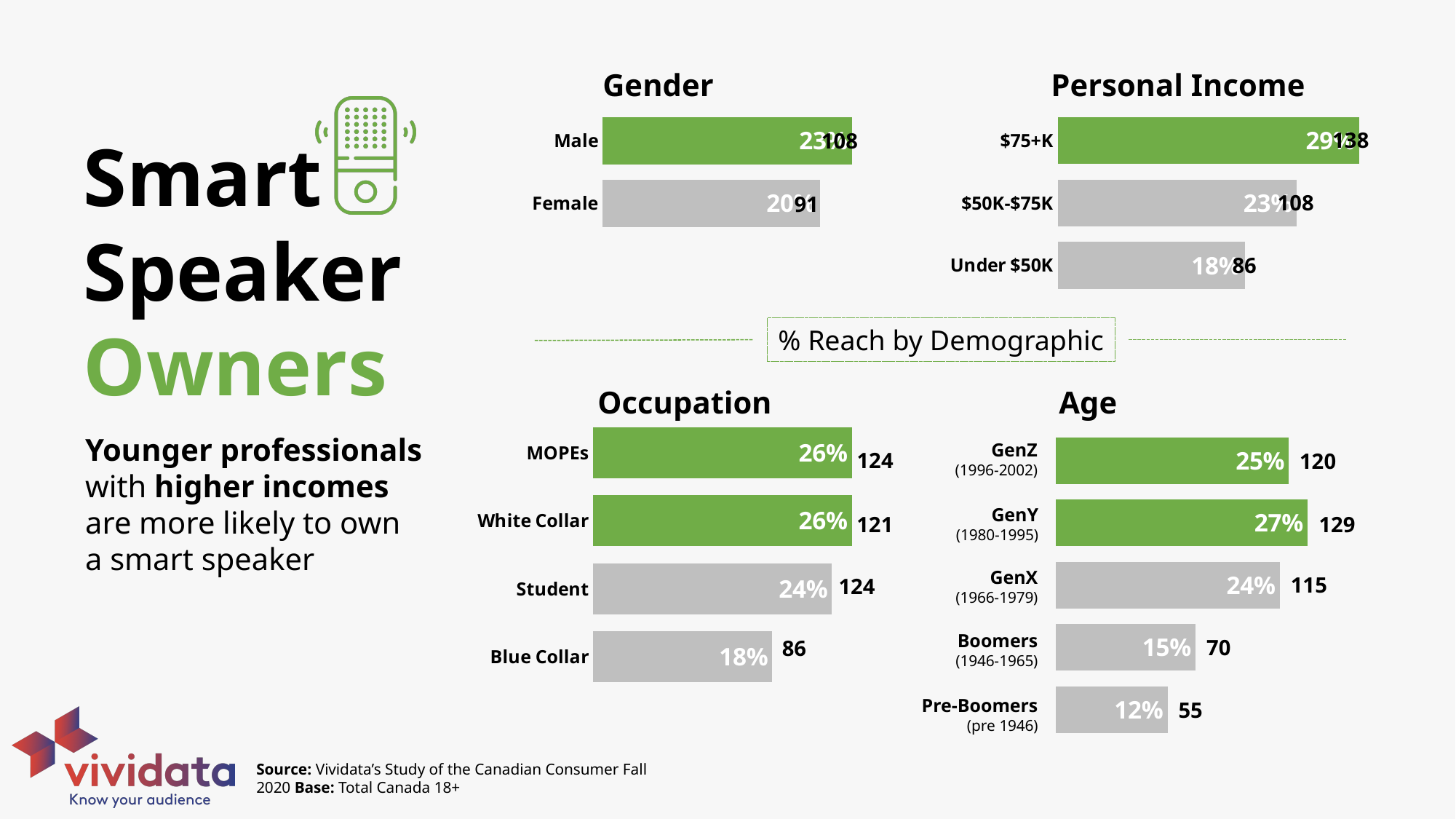
In the Occupation chart, what is the % reach for Blue Collar? 18% In the Age chart, what is the index number shown next to the Boomers bar? 70 In the Age chart, what is the difference in % reach between GenY and Pre-Boomers? 15 percentage points How many occupation categories are shown in the Occupation chart? 4 In the Age chart, which age group has the lowest % reach? Pre-Boomers In the Occupation chart, what is the index number shown next to the White Collar bar? 121 How many age groups are shown in the Age chart? 5 In the Age chart, what is the % reach for GenY (1980-1995)? 27% What type of chart is used to show % reach by demographic on this slide? Bar chart In the Personal Income chart, what is the index number shown next to the $75+K bar? 138 In the Gender chart, what is the index number shown next to the Male bar? 108 In the Occupation chart, which has a higher % reach, Student or Blue Collar? Student